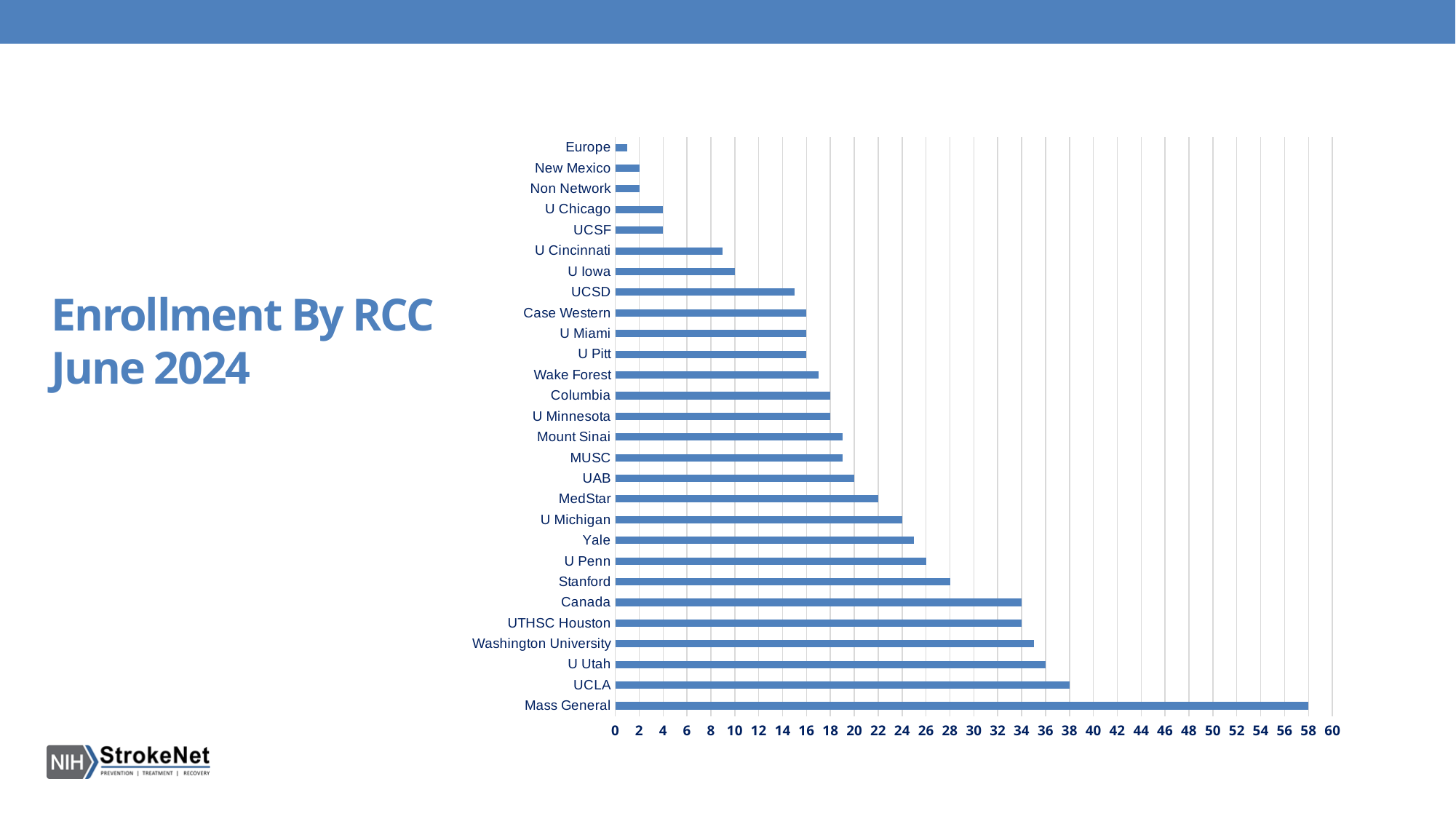
What is the enrollment value for U Utah? 36 What is the title of the slide containing the chart? Enrollment By RCC June 2024 What is the enrollment value for UCLA? 38 Which RCC has the highest enrollment? Mass General Which has a higher enrollment, Stanford or Yale? Stanford What is the enrollment value for Mass General? 58 Is the enrollment for U Cincinnati greater or less than 10? less Is the enrollment for Washington University greater or less than 30? greater How many RCCs are listed on the chart? 28 What type of chart is shown on the slide? bar chart What is the difference in enrollment between Mass General and UCLA? 20 Which RCC has the lowest enrollment? Europe